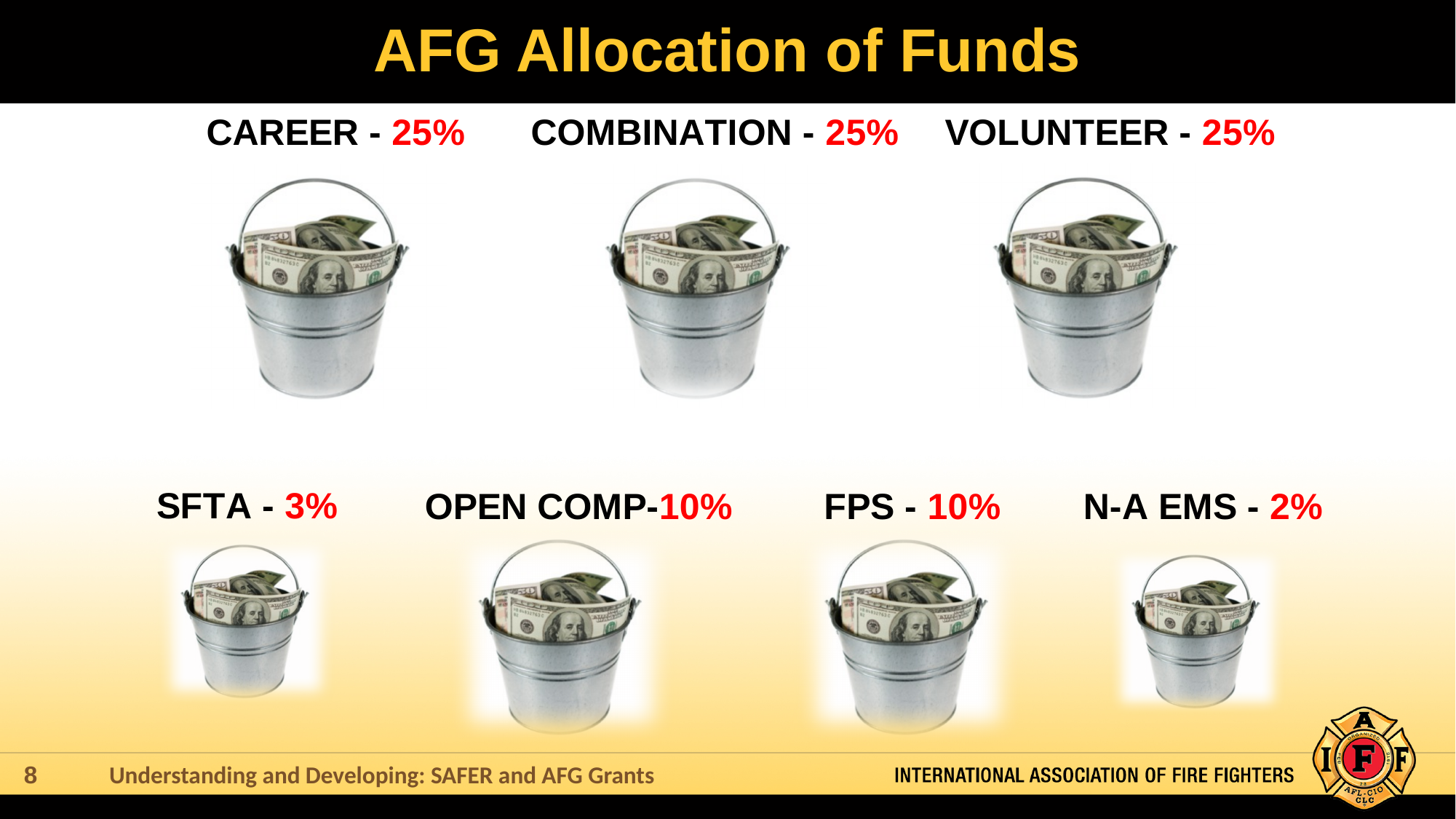
What percentage of AFG funds is allocated to OPEN COMP? 10% Which receives a larger share of AFG funds, SFTA or N-A EMS? SFTA What is the combined allocation for CAREER, COMBINATION and VOLUNTEER? 75% Which category receives the smallest share of AFG funds? N-A EMS What is the difference between the CAREER allocation and the FPS allocation? 15% Which receives a larger share of AFG funds, VOLUNTEER or FPS? VOLUNTEER What is the difference between the OPEN COMP allocation and the SFTA allocation? 7% How many allocation categories are shown on the slide? 7 What percentage of AFG funds is allocated to SFTA? 3% What percentage of AFG funds is allocated to N-A EMS? 2% What percentage of AFG funds is allocated to CAREER departments? 25% What kind of chart is used to show the AFG allocation of funds? Pictogram (buckets of money sized by percentage)